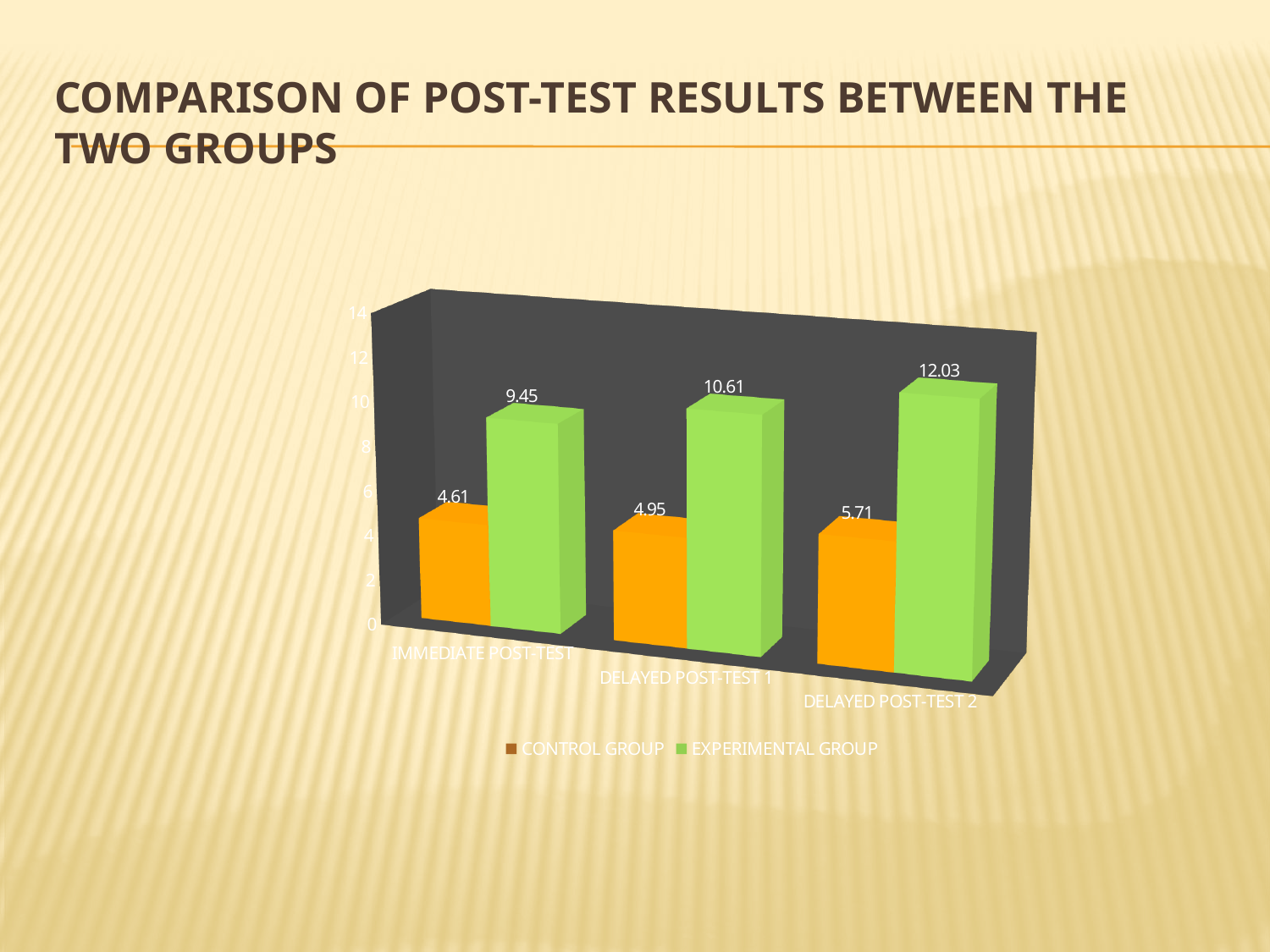
At which test does the Experimental Group have its highest value? Delayed Post-Test 2 At which test does the Control Group have its lowest value? Immediate Post-Test How many test categories are shown on the x axis? 3 What is the value for the Control Group at Immediate Post-Test? 4.61 Which is larger at Delayed Post-Test 1: the Control Group value or the Experimental Group value? Experimental Group Do the Control Group values rise or fall from Immediate Post-Test to Delayed Post-Test 2? Rise What kind of chart is shown on the slide? Bar chart What is the value for the Control Group at Delayed Post-Test 2? 5.71 How many series does the legend list? 2 What is the value for the Experimental Group at Delayed Post-Test 1? 10.61 What is the value for the Experimental Group at Delayed Post-Test 2? 12.03 What is the difference between the Experimental Group and Control Group values at Immediate Post-Test? 4.84